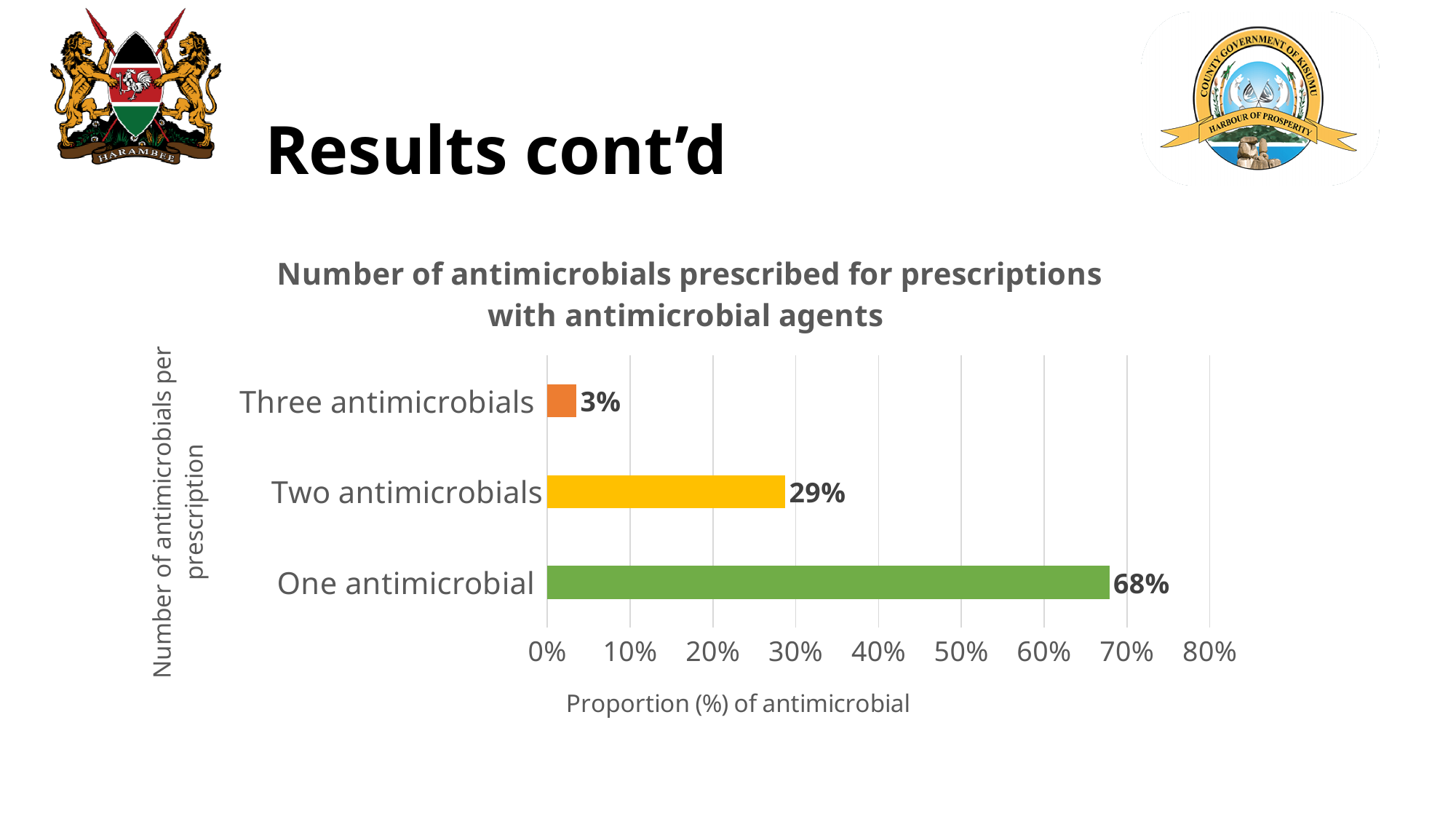
Which category has the lowest proportion? Three antimicrobials How many categories are shown in the chart? 3 Is the value for one antimicrobial greater or less than 60%? greater What proportion of prescriptions had three antimicrobials? 3% What is the difference in proportion between one antimicrobial and two antimicrobials? 39% What proportion of prescriptions had two antimicrobials? 29% Which category has the highest proportion? One antimicrobial What is the difference in proportion between two antimicrobials and three antimicrobials? 26% What proportion of prescriptions had one antimicrobial? 68% Which is larger, the proportion for two antimicrobials or for three antimicrobials? Two antimicrobials What kind of chart is shown on the slide? Bar chart What is the label of the horizontal axis of the chart? Proportion (%) of antimicrobial